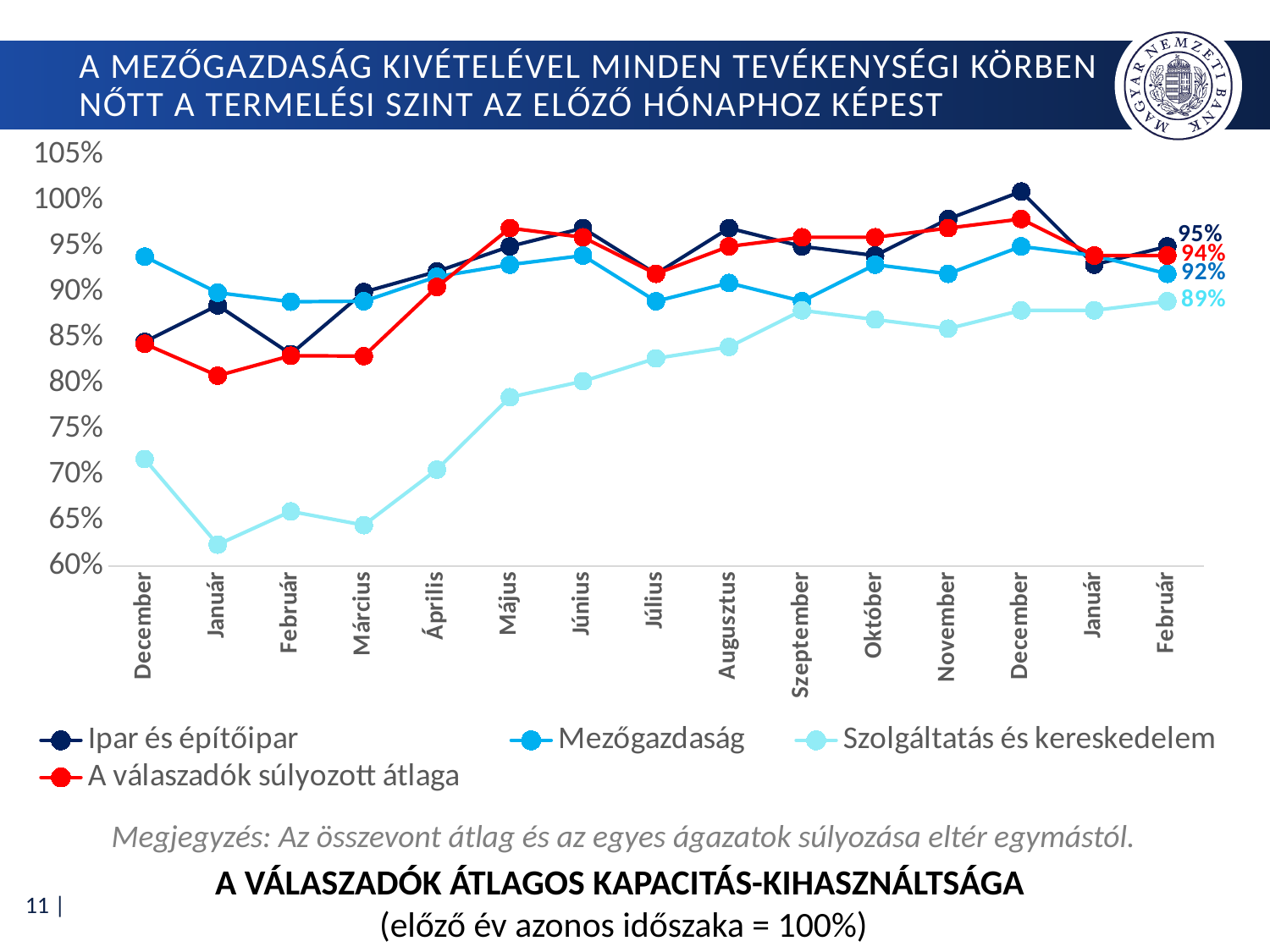
What is the value for Mezőgazdaság in the final Február? 92% Is the value for Szolgáltatás és kereskedelem in the first Január greater or less than 65%? less What is the value for Szolgáltatás és kereskedelem in the final Február? 89% How many series does the legend list? 4 What kind of chart is shown on the slide? line chart Does the Szolgáltatás és kereskedelem line rise or fall from Március to Szeptember? rise Which series has the highest value in the final Február? Ipar és építőipar In the final Február, what is the difference between Ipar és építőipar and Szolgáltatás és kereskedelem? 6 percentage points What is the value for A válaszadók súlyozott átlaga in the final Február? 94% Which series has the lowest value in the final Február? Szolgáltatás és kereskedelem How many months are shown along the x axis? 15 What is the value for Ipar és építőipar in the final Február? 95%